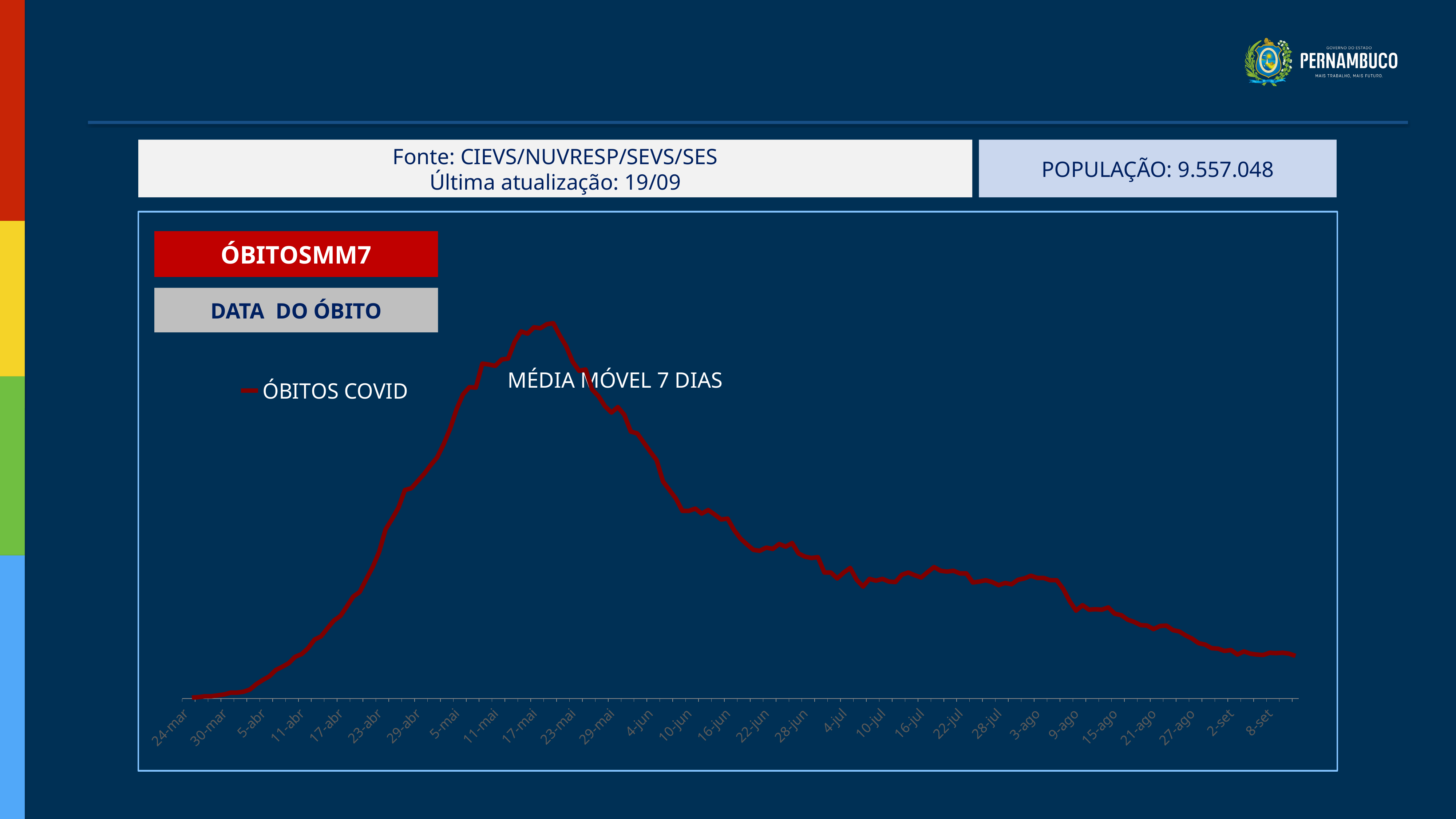
Does the line rise or fall between 24-mar and 17-mai? rise Between which two x-axis labels does the line reach its peak? 17-mai and 23-mai Does the line rise or fall between 23-mai and 8-set? fall What is the first date label on the x axis? 24-mar What kind of chart is shown on the slide? line chart How many date labels are shown on the x axis of the chart? 29 What is the last date label on the x axis? 8-set Which is larger, the value at 5-abr or the value at 5-mai? 5-mai How many series does the chart legend list? 1 What is the name of the series shown in the chart legend? ÓBITOS COVID Which is larger, the value at 17-mai or the value at 8-set? 17-mai What is the title shown in the red box above the chart? ÓBITOSMM7